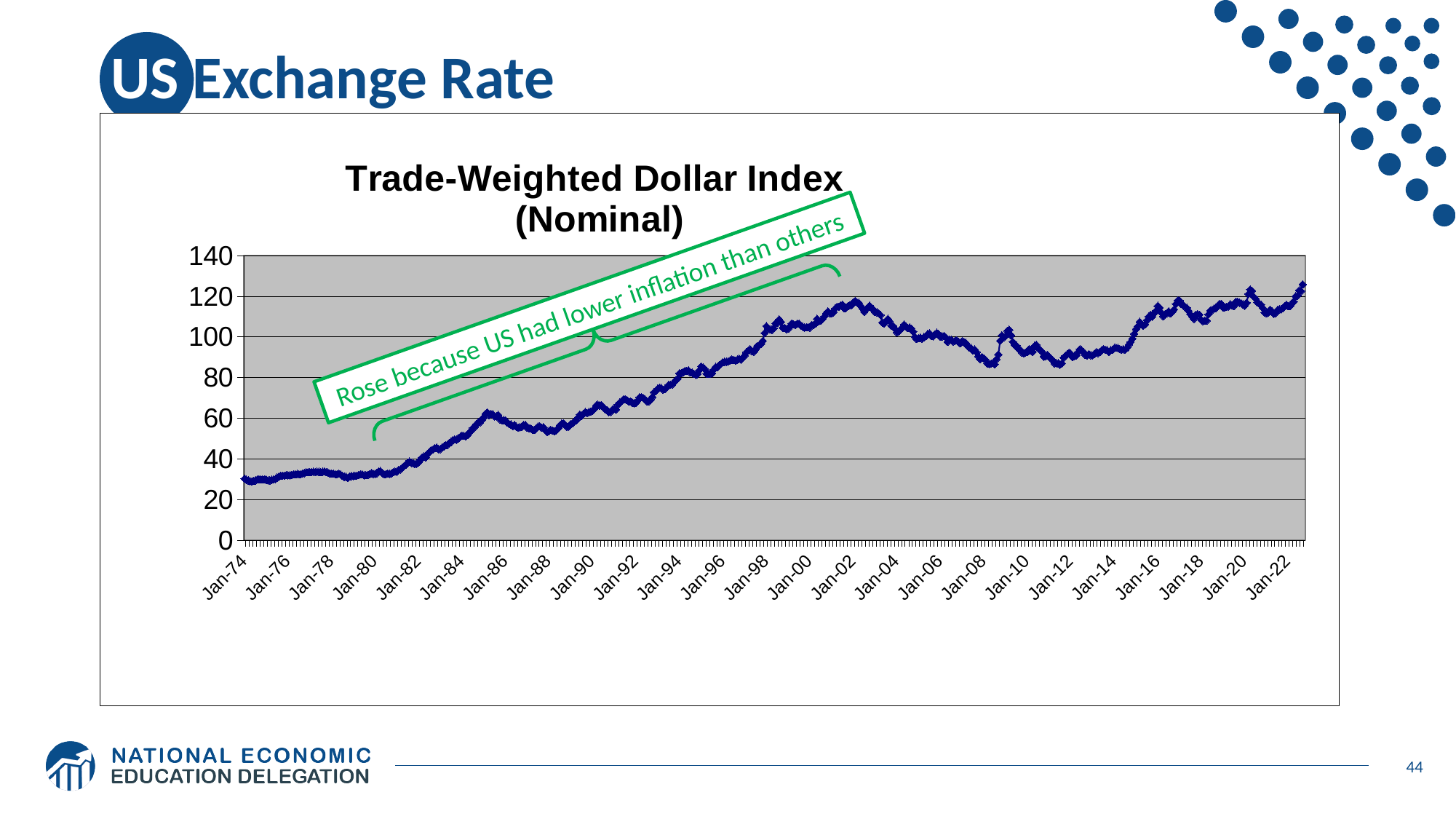
Is the value of the index at Jan-96 greater or less than 60? greater Is the value of the index at Jan-74 greater or less than 40? less Which is larger, the index value at Jan-86 or at Jan-16? Jan-16 Is the value of the index at Jan-22 greater or less than 100? greater What does the green annotation on the chart say? Rose because US had lower inflation than others Around which x-axis label is the index at its lowest? Jan-74 Which is larger, the index value at Jan-02 or at Jan-74? Jan-02 What is the title of the chart? Trade-Weighted Dollar Index (Nominal) What kind of chart is shown on the slide? line chart Overall, does the Trade-Weighted Dollar Index rise or fall from Jan-74 to Jan-22? rise